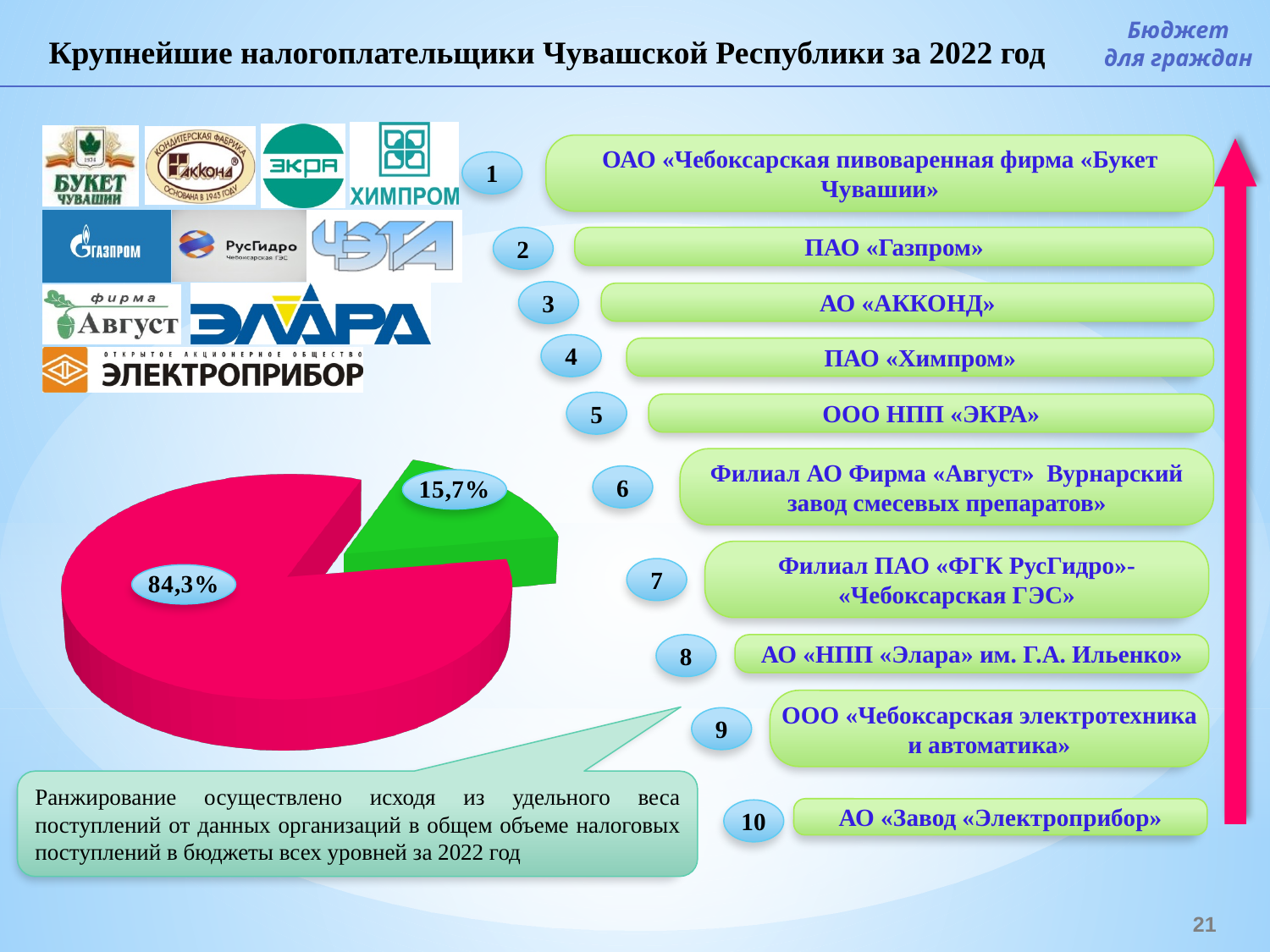
Which is larger in the pie chart, the pink slice or the green slice? the pink slice How many slices does the pie chart have? 2 Is the value of the green slice in the pie chart greater or less than 20%? less What value is shown on the large pink slice of the pie chart? 84,3% Which slice of the pie chart is the smallest? the green slice (15,7%) What colour is the slice labelled 15,7% in the pie chart? green What value is shown on the green slice of the pie chart? 15,7% What kind of chart is shown on the slide? pie chart What is the difference between the two slice values in the pie chart? 68,6% Which slice of the pie chart is the largest? the pink slice (84,3%) What do the two slice values in the pie chart add up to? 100% Is the value of the pink slice in the pie chart greater or less than 80%? greater